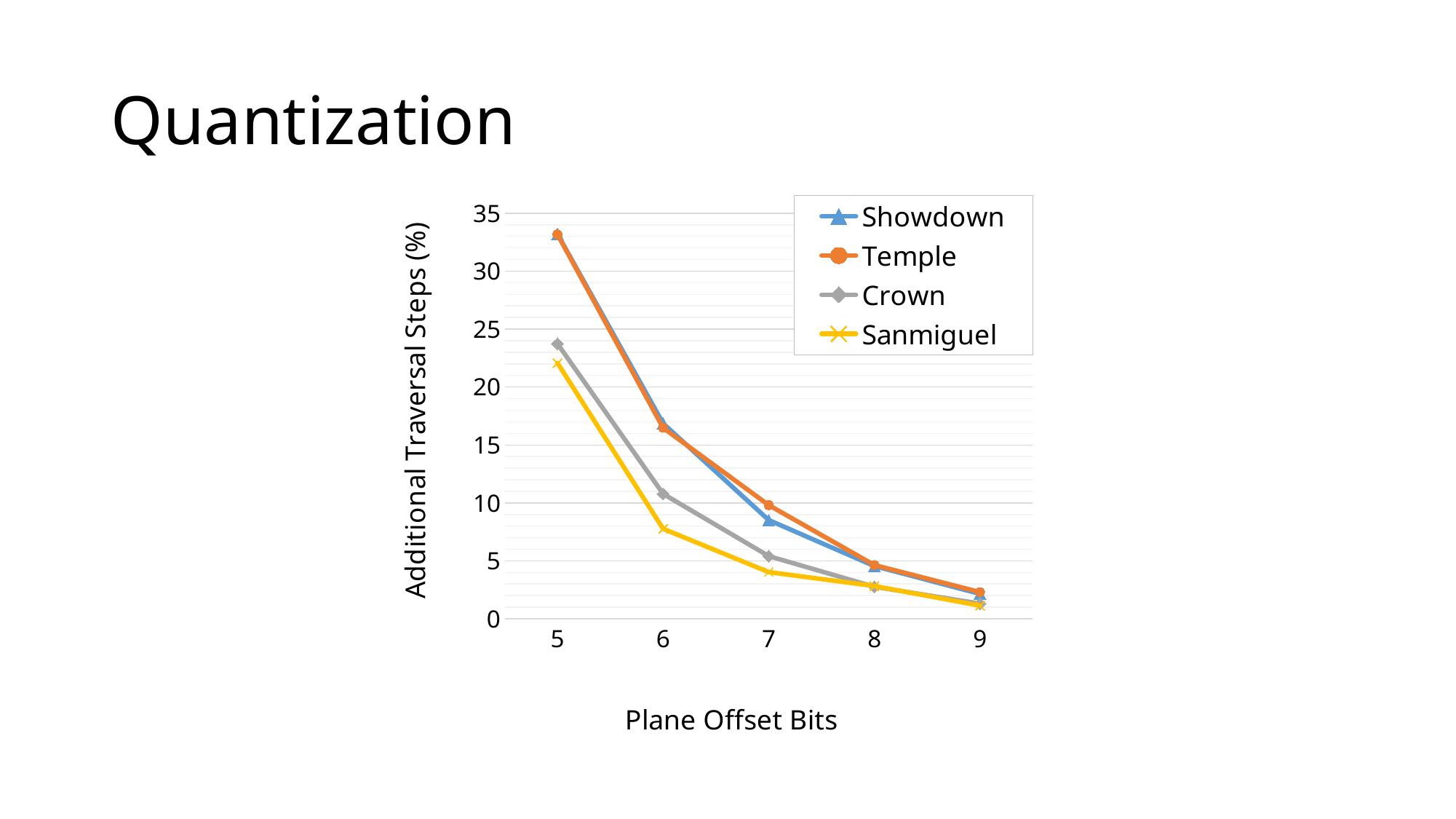
Which series has the lowest value at 6 plane offset bits? Sanmiguel Is the value for Showdown at 6 plane offset bits greater or less than 15? greater Do the additional traversal steps rise or fall as the plane offset bits increase? fall What is the title of the y axis? Additional Traversal Steps (%) At 7 plane offset bits, which is larger, Temple or Sanmiguel? Temple Is the value for Sanmiguel at 6 plane offset bits greater or less than 10? less What is the title of the x axis? Plane Offset Bits Is the value for Crown at 5 plane offset bits greater or less than 25? less What kind of chart is shown on the slide? line chart How many plane offset bit values are plotted along the x axis? 5 How many series does the legend list? 4